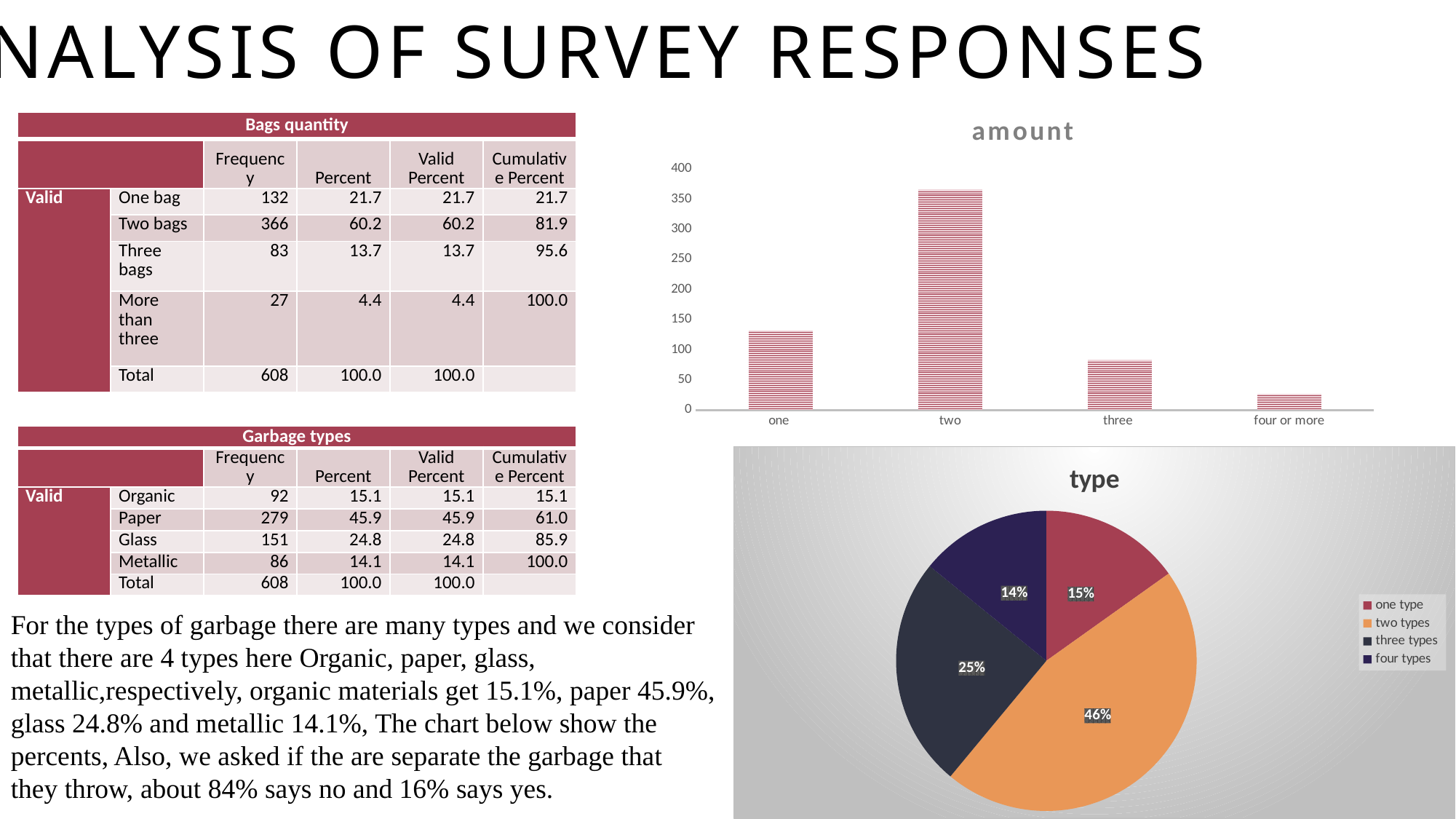
In the pie chart titled "type", which slice is the largest? two types In the chart titled "amount", which is larger, the bar for "one" or the bar for "three"? one In the pie chart titled "type", what colour is the "two types" slice? orange In the chart titled "amount", is the value for "one" greater or less than 100? greater How many categories are shown on the x axis of the chart titled "amount"? 4 In the pie chart titled "type", what is the difference between the shares of "two types" and "three types"? 21% What kind of chart is the chart titled "amount"? bar chart In the pie chart titled "type", what share does "two types" have? 46% In the chart titled "amount", which category has the highest bar? two In the chart titled "amount", is the value for "three" greater or less than 100? less In the chart titled "amount", which category has the lowest bar? four or more In the pie chart titled "type", what share does "three types" have? 25%